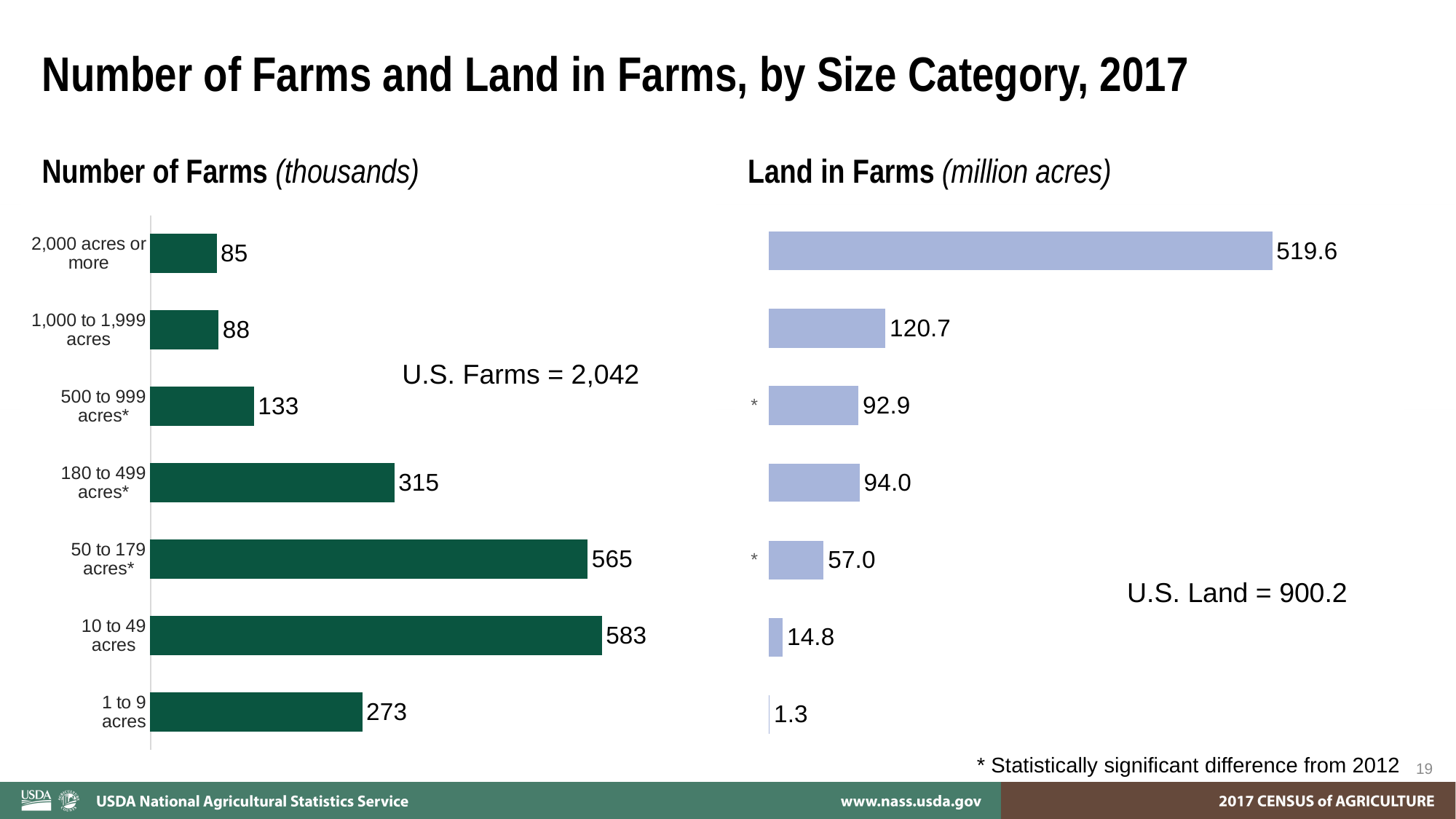
In the Land in Farms chart, what is the value for the top bar (2,000 acres or more)? 519.6 In the Land in Farms chart, which size category has the lowest value? 1 to 9 acres What type of chart is the Land in Farms chart? Bar chart In the Land in Farms chart, what is the difference between the values for 2,000 acres or more and 1,000 to 1,999 acres? 398.9 In the Number of Farms chart, which is larger: the value for 180 to 499 acres or the value for 1 to 9 acres? 180 to 499 acres In the Number of Farms chart, what is the value for 50 to 179 acres? 565 In the Number of Farms chart, which size category has the highest value? 10 to 49 acres In the Land in Farms chart, what is the value for the bottom bar (1 to 9 acres)? 1.3 How many size categories are shown in the Number of Farms chart? 7 In the Number of Farms chart, what is the value for 2,000 acres or more? 85 In the Number of Farms chart, what is the difference between the values for 10 to 49 acres and 50 to 179 acres? 18 In the Number of Farms chart, which size category has the lowest value? 2,000 acres or more